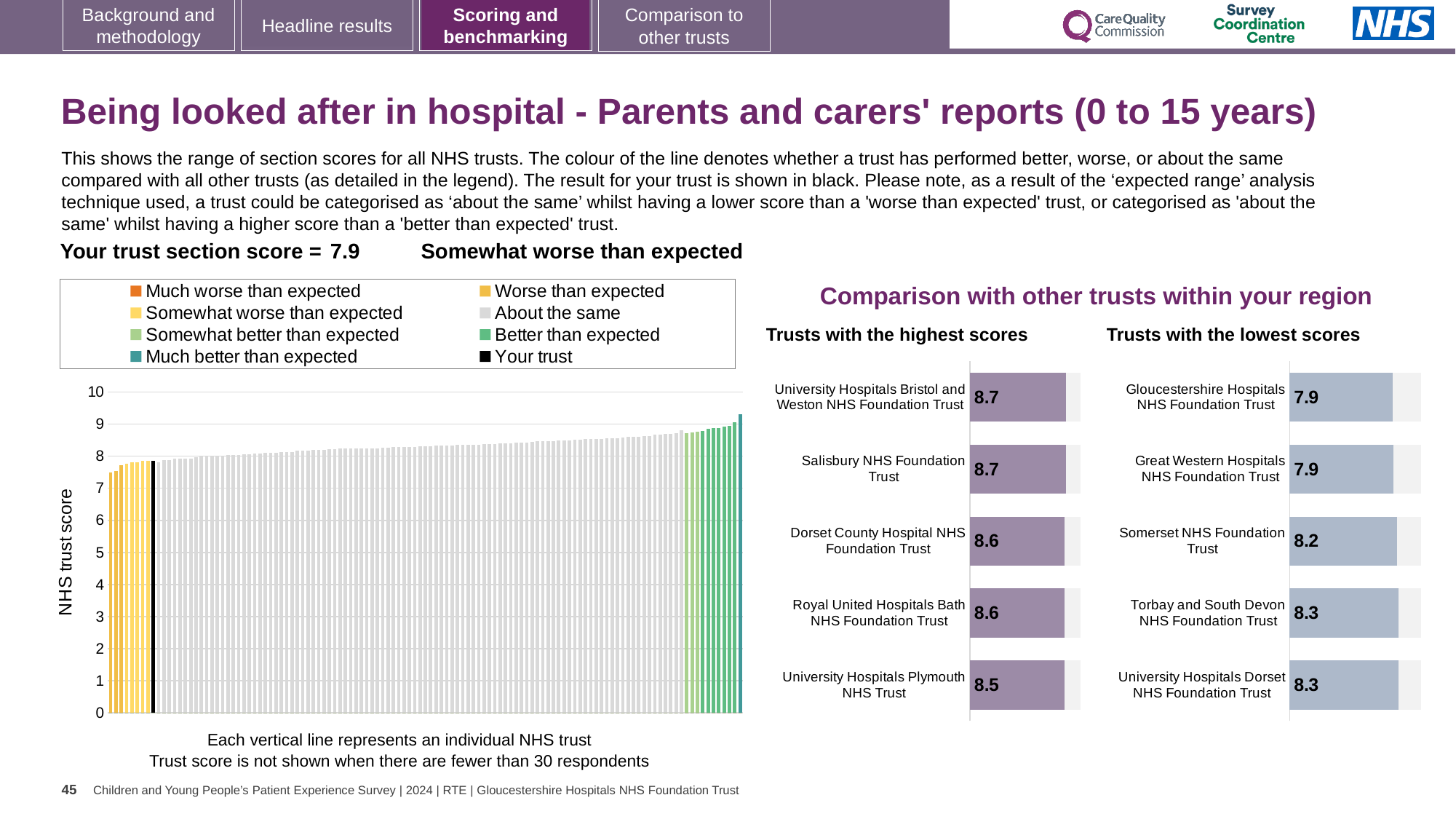
In the 'Trusts with the lowest scores' chart, what is the difference between the scores of Somerset NHS Foundation Trust and Gloucestershire Hospitals NHS Foundation Trust? 0.3 In the 'Trusts with the highest scores' chart, which has the higher score: Dorset County Hospital NHS Foundation Trust or University Hospitals Plymouth NHS Trust? Dorset County Hospital NHS Foundation Trust In the 'Trusts with the lowest scores' chart, what is the score for Somerset NHS Foundation Trust? 8.2 What kind of chart is the main chart on the left showing NHS trust scores? Bar chart In the 'Trusts with the highest scores' chart, what is the score for Salisbury NHS Foundation Trust? 8.7 What is the y-axis label of the main chart on the left? NHS trust score How many entries does the legend of the main chart on the left list? 8 How many trusts are shown in the 'Trusts with the lowest scores' chart? 5 In the 'Trusts with the lowest scores' chart, what is the score for Torbay and South Devon NHS Foundation Trust? 8.3 In the 'Trusts with the highest scores' chart, which trust has the lowest score? University Hospitals Plymouth NHS Trust In the 'Trusts with the highest scores' chart, what is the score for University Hospitals Plymouth NHS Trust? 8.5 In the 'Trusts with the highest scores' chart, what is the difference between the scores of University Hospitals Bristol and Weston NHS Foundation Trust and University Hospitals Plymouth NHS Trust? 0.2